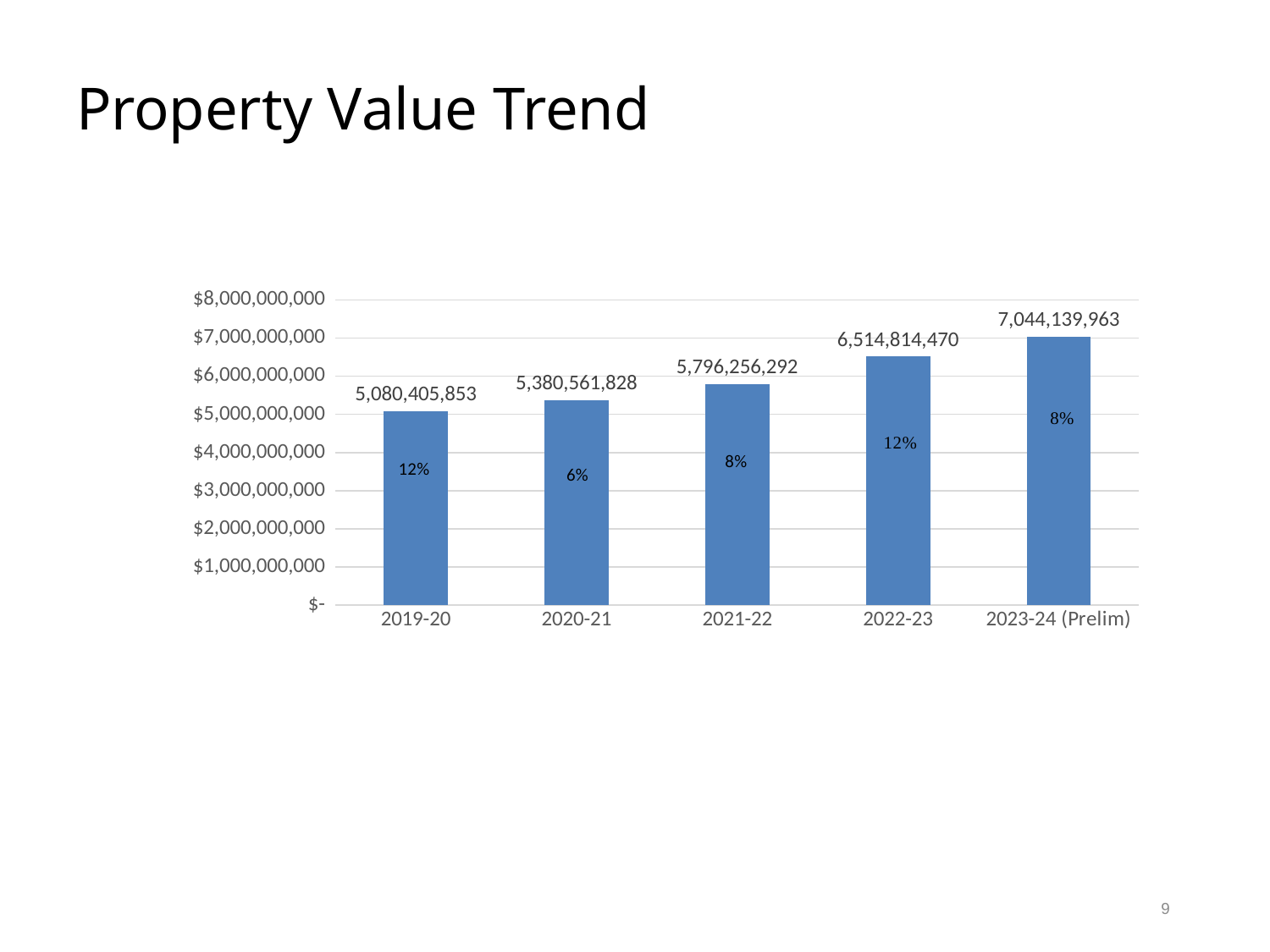
What is the property value for 2022-23? 6,514,814,470 What is the property value for 2023-24 (Prelim)? 7,044,139,963 Is the value for 2021-22 greater or less than $5,000,000,000? greater What is the property value for 2019-20? 5,080,405,853 What percentage is shown inside the bar for 2020-21? 6% What kind of chart is shown on the slide? bar chart Which year has the highest property value? 2023-24 (Prelim) Which year has the lowest property value? 2019-20 Which is larger, the property value for 2021-22 or for 2022-23? 2022-23 What is the difference between the property values for 2021-22 and 2020-21? 415,694,464 Do the property values rise or fall from 2019-20 to 2023-24 (Prelim)? rise How many years are shown on the x axis? 5